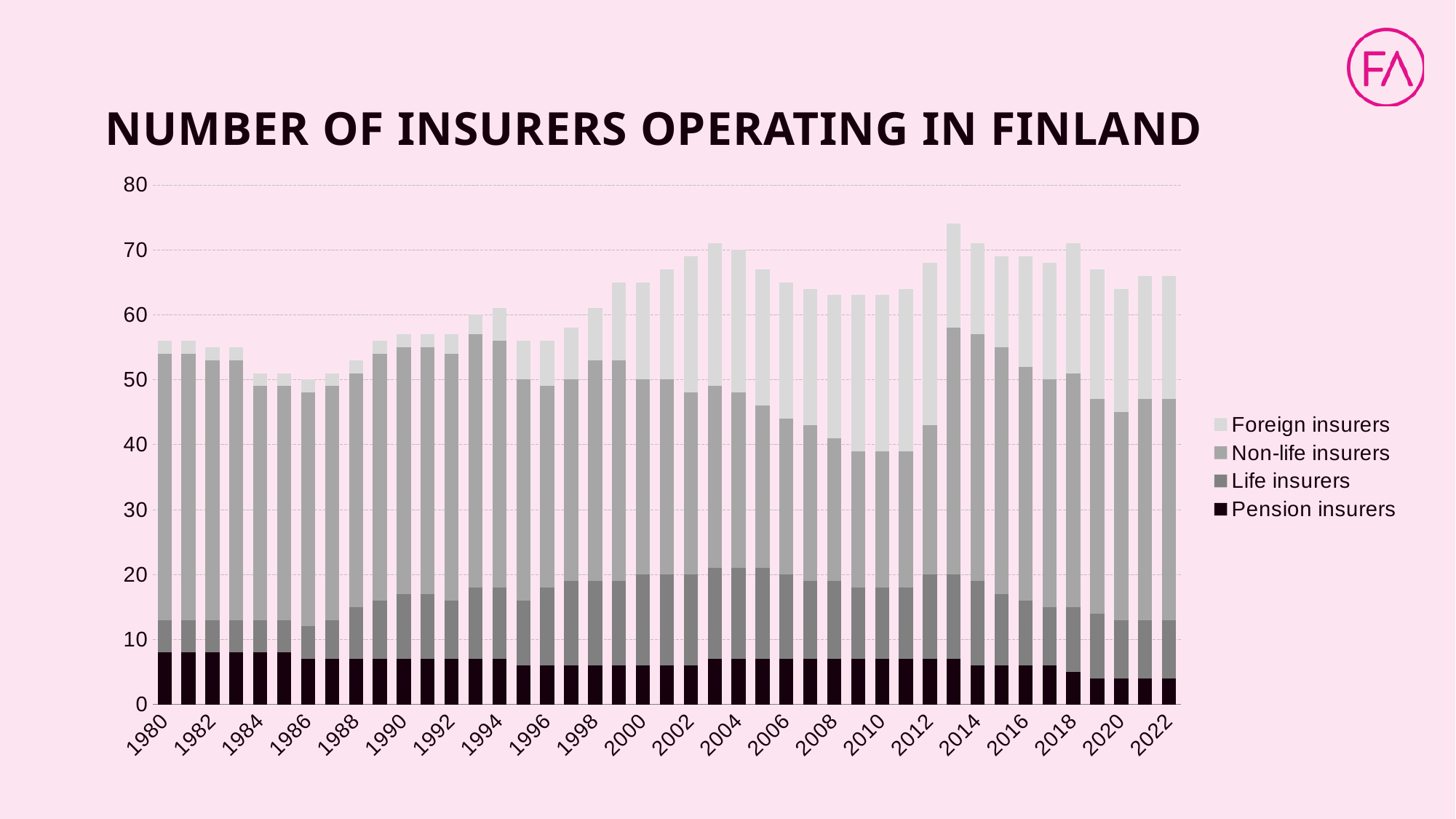
Which year has the highest total number of insurers? 2013 How many series does the legend list? 4 What kind of chart is shown on the slide? Stacked bar chart Is the total number of insurers in 1986 greater or less than 60? less Is the total number of insurers in 2013 greater or less than 70? greater Is the number of pension insurers in 1980 greater or less than 10? less Which year has the larger total number of insurers, 1980 or 2000? 2000 What is the title of the chart? NUMBER OF INSURERS OPERATING IN FINLAND How many years (bars) are plotted in the chart? 43 Does the total number of insurers rise or fall from 2003 to 2010? fall Which series is shown at the bottom of each stacked bar? Pension insurers